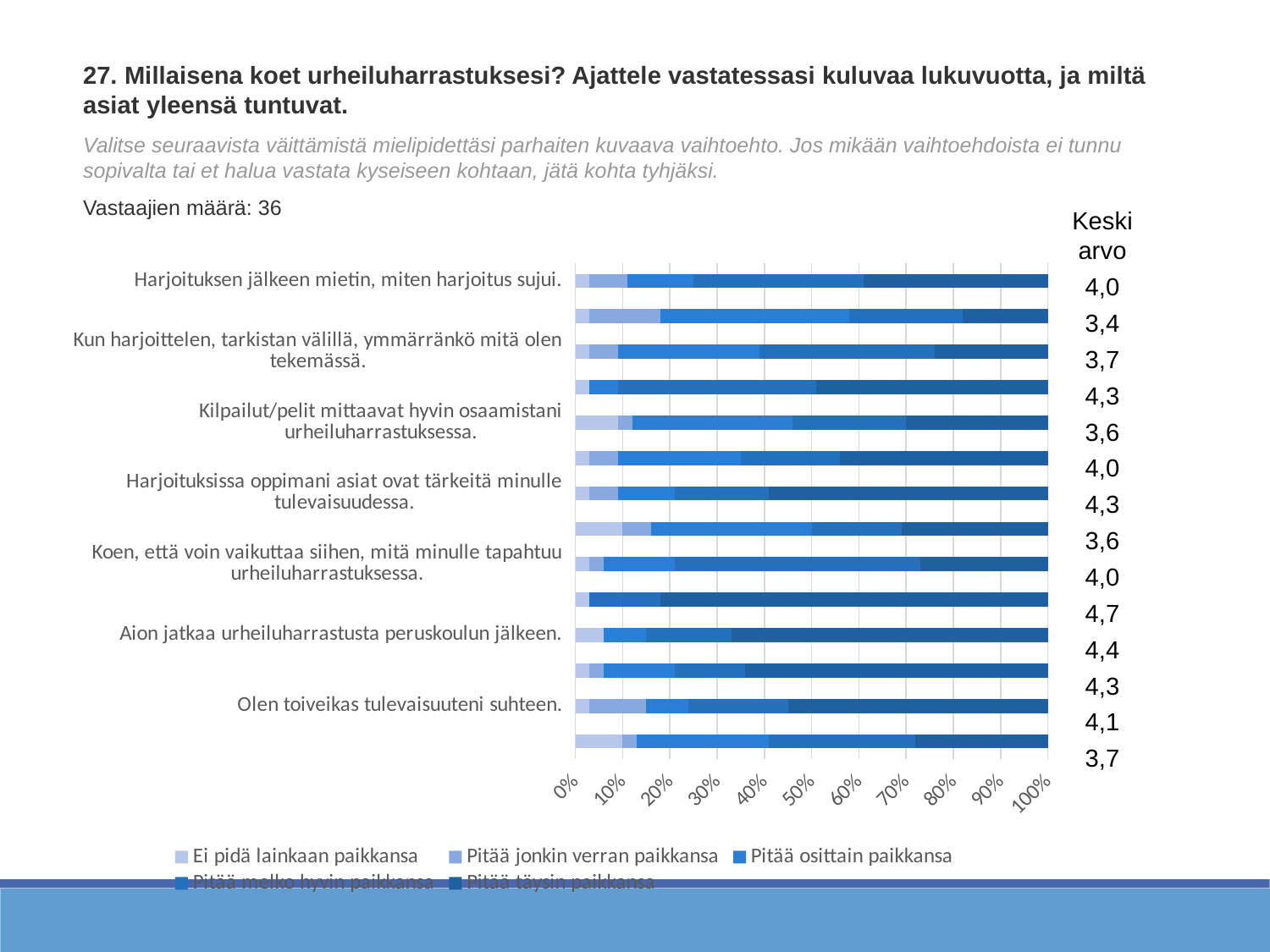
What is the first legend entry of the chart? Ei pidä lainkaan paikkansa What is the maximum value shown on the chart's horizontal axis? 100% How many bars are plotted in the chart? 14 How many series does the chart legend list? 5 What Keskiarvo value is listed for the first bar, 'Harjoituksen jälkeen mietin, miten harjoitus sujui.'? 4,0 What kind of chart is shown on the slide? Stacked bar chart How many respondents (Vastaajien määrä) does the slide report for this chart? 36 What is the lowest value listed in the Keskiarvo column next to the chart? 3,4 What is the difference between the highest and lowest Keskiarvo values listed next to the chart? 1,3 What is the highest value listed in the Keskiarvo column next to the chart? 4,7 In the first bar ('Harjoituksen jälkeen mietin, miten harjoitus sujui.'), is the 'Ei pidä lainkaan paikkansa' segment greater or less than 20%? less